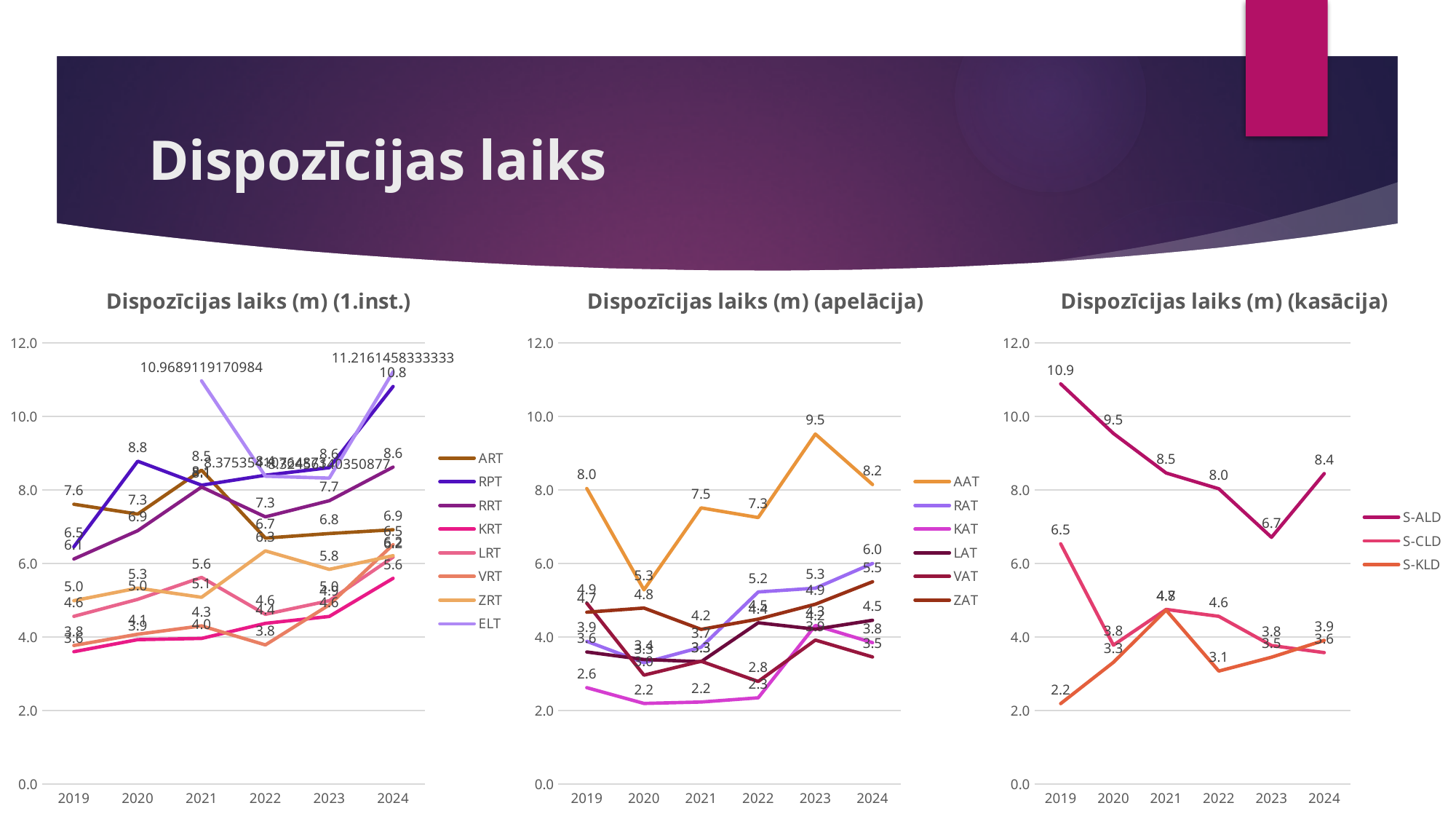
In the chart titled "Dispozīcijas laiks (m) (kasācija)", what is the value for S-KLD in 2019? 2.2 What kind of chart is "Dispozīcijas laiks (m) (1.inst.)"? line chart In the chart titled "Dispozīcijas laiks (m) (apelācija)", which year has the highest value for AAT? 2023 In the chart titled "Dispozīcijas laiks (m) (apelācija)", what is the value for AAT in 2023? 9.5 How many charts are on the slide? 3 In the chart titled "Dispozīcijas laiks (m) (1.inst.)", is the value for ELT in 2024 greater or less than 10.0? greater In the chart titled "Dispozīcijas laiks (m) (1.inst.)", what is the value for RPT in 2020? 8.8 In the chart titled "Dispozīcijas laiks (m) (kasācija)", what is the value for S-ALD in 2019? 10.9 In the chart titled "Dispozīcijas laiks (m) (apelācija)", how many series does the legend list? 6 In the chart titled "Dispozīcijas laiks (m) (kasācija)", what is the difference between the S-ALD values in 2019 and 2024? 2.5 In the chart titled "Dispozīcijas laiks (m) (kasācija)", which year has the lowest value for S-ALD? 2023 In the chart titled "Dispozīcijas laiks (m) (kasācija)", how many series does the legend list? 3